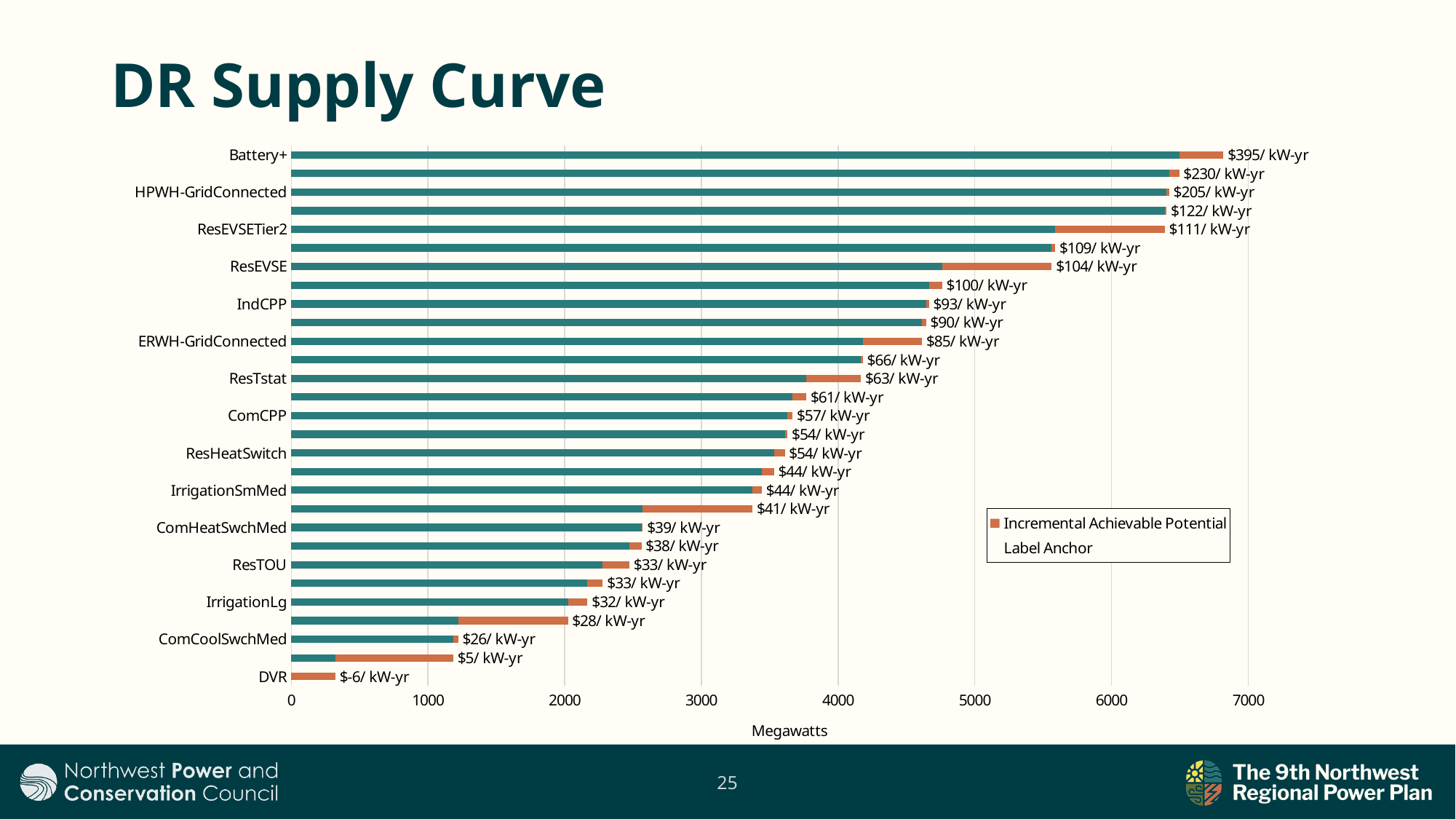
What is the data label shown for HPWH-GridConnected? $205/ kW-yr Is the total bar length for ComCoolSwchMed greater or less than 2000 megawatts? less Which labeled category has the lowest $/kW-yr data label? DVR What is the data label shown for Battery+? $395/ kW-yr What is the data label shown for DVR? $-6/ kW-yr What is the data label shown for ERWH-GridConnected? $85/ kW-yr How many series does the legend list? 2 Which labeled category has the highest $/kW-yr data label? Battery+ What is the difference between the data labels for Battery+ and HPWH-GridConnected? $190/ kW-yr What is the data label shown for ResEVSETier2? $111/ kW-yr Is the total bar length for Battery+ greater or less than 6000 megawatts? greater What kind of chart is shown on the slide? Bar chart